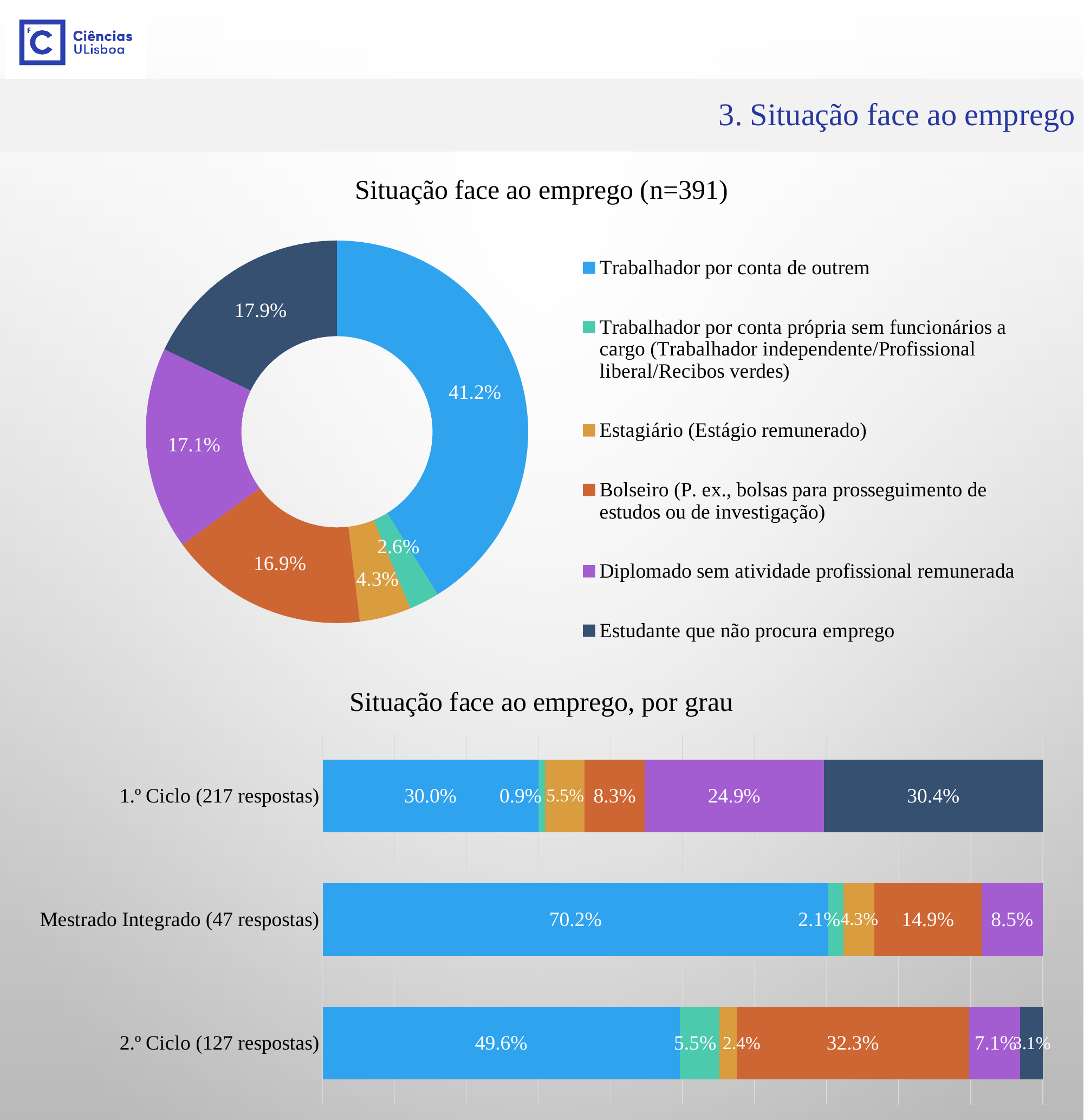
In the chart "Situação face ao emprego, por grau", how many degree categories are shown on the vertical axis? 3 In the doughnut chart "Situação face ao emprego (n=391)", what percentage is shown for "Trabalhador por conta de outrem"? 41.2% In the chart "Situação face ao emprego, por grau", what is the value of the first (blue) segment for "Mestrado Integrado (47 respostas)"? 70.2% In the doughnut chart "Situação face ao emprego (n=391)", what is the difference between the share for "Estudante que não procura emprego" and the share for "Bolseiro"? 1.0% In the chart "Situação face ao emprego, por grau", what is the value of the orange (Bolseiro) segment for "2.º Ciclo (127 respostas)"? 32.3% In the chart "Situação face ao emprego, por grau", which degree has the larger first (blue) segment: "1.º Ciclo (217 respostas)" or "2.º Ciclo (127 respostas)"? 2.º Ciclo (127 respostas) What type of chart is the bottom chart titled "Situação face ao emprego, por grau"? Stacked bar chart What type of chart is the top chart titled "Situação face ao emprego (n=391)"? Doughnut chart In the doughnut chart "Situação face ao emprego (n=391)", which category has the smallest share? Trabalhador por conta própria sem funcionários a cargo (Trabalhador independente/Profissional liberal/Recibos verdes) In the chart "Situação face ao emprego, por grau", what is the value of the last (dark blue) segment for "1.º Ciclo (217 respostas)"? 30.4% In the doughnut chart "Situação face ao emprego (n=391)", how many categories does the legend list? 6 In the doughnut chart "Situação face ao emprego (n=391)", what percentage is shown for "Estagiário (Estágio remunerado)"? 4.3%